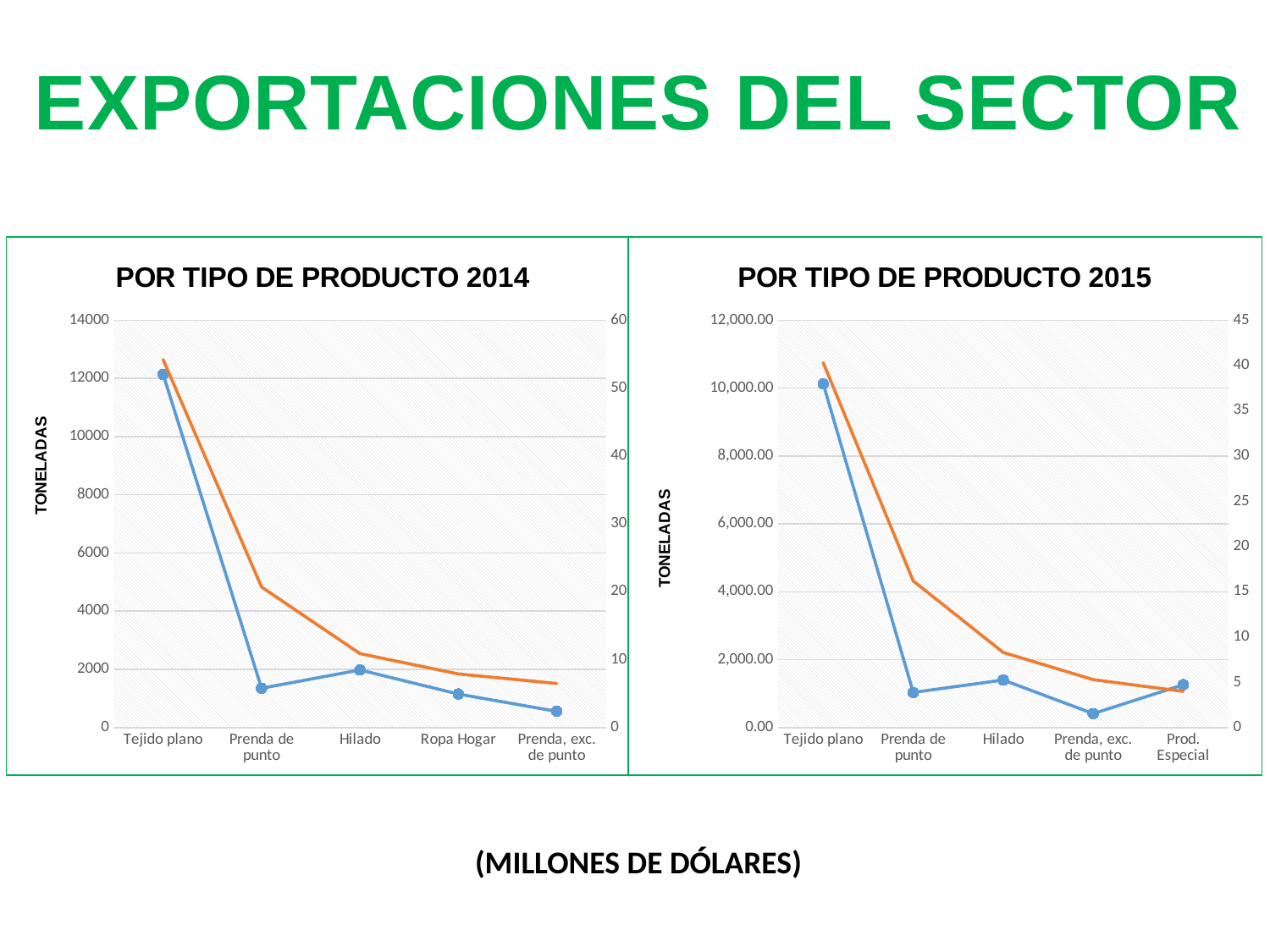
In 'POR TIPO DE PRODUCTO 2014', which category has the highest value on the blue line? Tejido plano In 'POR TIPO DE PRODUCTO 2014', is the blue-line value for Tejido plano greater or less than 10000? greater In 'POR TIPO DE PRODUCTO 2015', is the blue-line value for Tejido plano greater or less than 8,000.00? greater What is the label on the left vertical axis of 'POR TIPO DE PRODUCTO 2014'? TONELADAS In 'POR TIPO DE PRODUCTO 2015', does the orange line generally rise or fall from Tejido plano to Prod. Especial? fall In 'POR TIPO DE PRODUCTO 2014', which has the larger blue-line value, Hilado or Prenda de punto? Hilado How many lines are plotted in 'POR TIPO DE PRODUCTO 2015'? 2 In 'POR TIPO DE PRODUCTO 2015', which category has the lowest value on the blue line? Prenda, exc. de punto What kind of chart is 'POR TIPO DE PRODUCTO 2014'? line chart How many product categories are shown on the x axis of 'POR TIPO DE PRODUCTO 2015'? 5 In 'POR TIPO DE PRODUCTO 2014', which category has the lowest value on the blue line? Prenda, exc. de punto In 'POR TIPO DE PRODUCTO 2014', is the blue-line value for Hilado greater or less than 4000? less